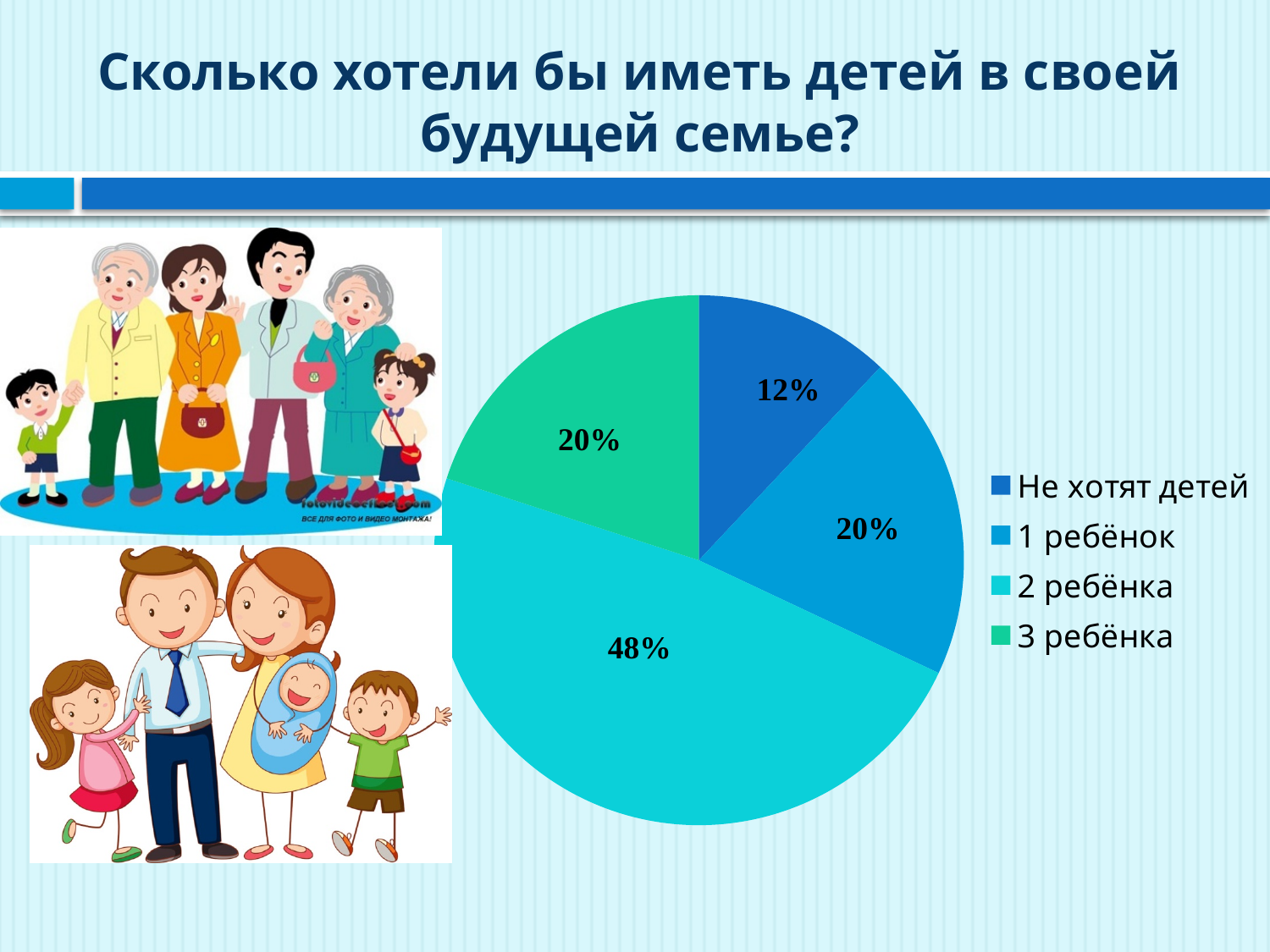
What share of the pie corresponds to "2 ребёнка"? 48% What share of the pie corresponds to "Не хотят детей"? 12% What share of the pie corresponds to "1 ребёнок"? 20% Which slice is larger: "1 ребёнок" or "Не хотят детей"? 1 ребёнок What is the title of the slide containing the pie chart? Сколько хотели бы иметь детей в своей будущей семье? Which category has the largest slice of the pie? 2 ребёнка What is the difference in percentage points between the "2 ребёнка" slice and the "Не хотят детей" slice? 36 How many slices does the pie chart have? 4 What type of chart is shown on the slide? pie chart How many entries does the legend list? 4 Which category has the smallest slice of the pie? Не хотят детей What share of the pie corresponds to "3 ребёнка"? 20%